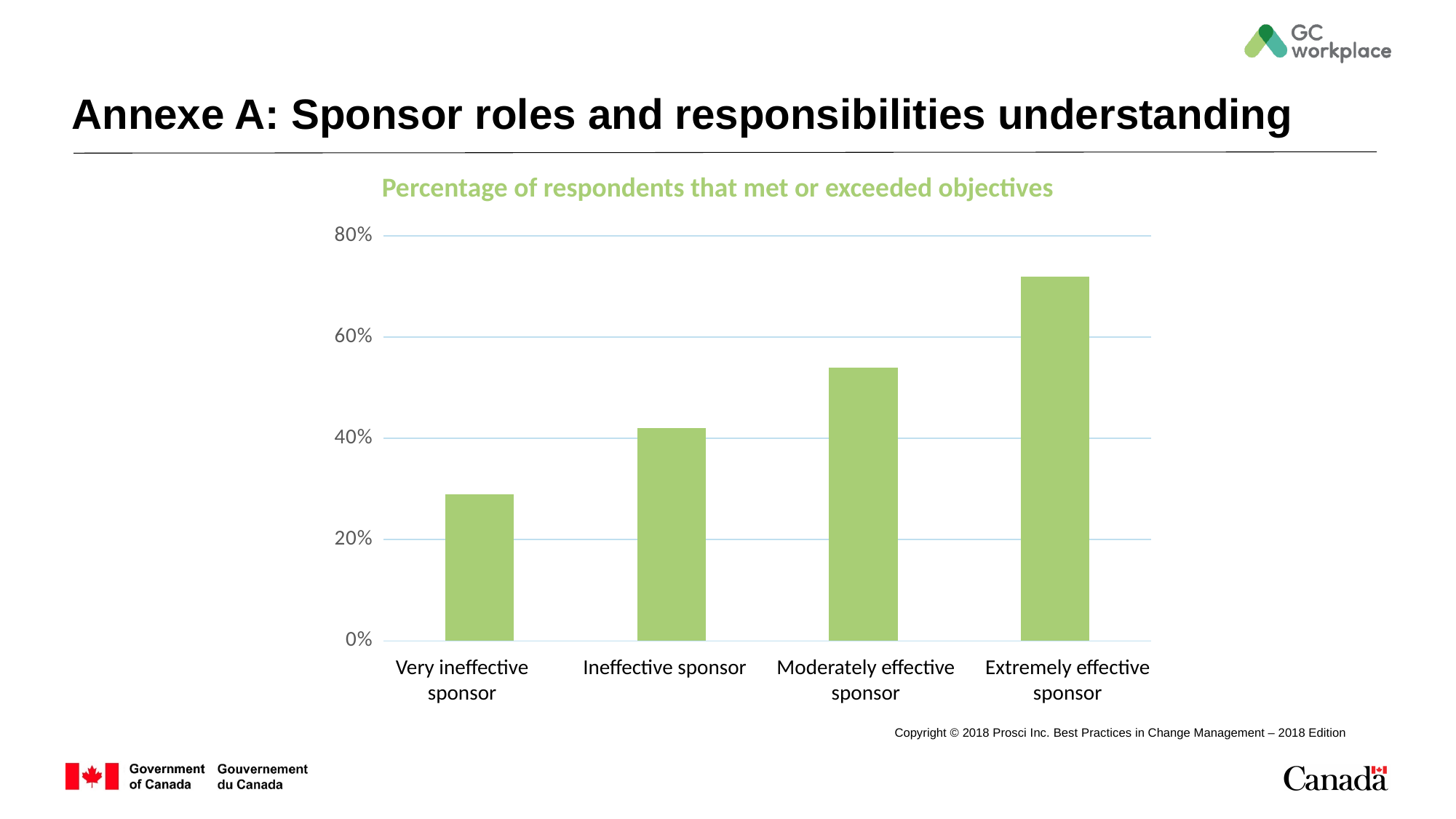
Is the value for Ineffective sponsor greater or less than 60%? less Is the value for Very ineffective sponsor greater or less than 20%? greater Is the value for Moderately effective sponsor greater or less than 60%? less Which is larger, the value for Ineffective sponsor or the value for Moderately effective sponsor? Moderately effective sponsor Do the values rise or fall moving from Very ineffective sponsor to Extremely effective sponsor along the x axis? rise What is the title of the chart? Percentage of respondents that met or exceeded objectives What kind of chart is shown on the slide? bar chart Which category has the highest percentage of respondents that met or exceeded objectives? Extremely effective sponsor Which category has the lowest percentage of respondents that met or exceeded objectives? Very ineffective sponsor How many categories are shown on the x axis of the chart? 4